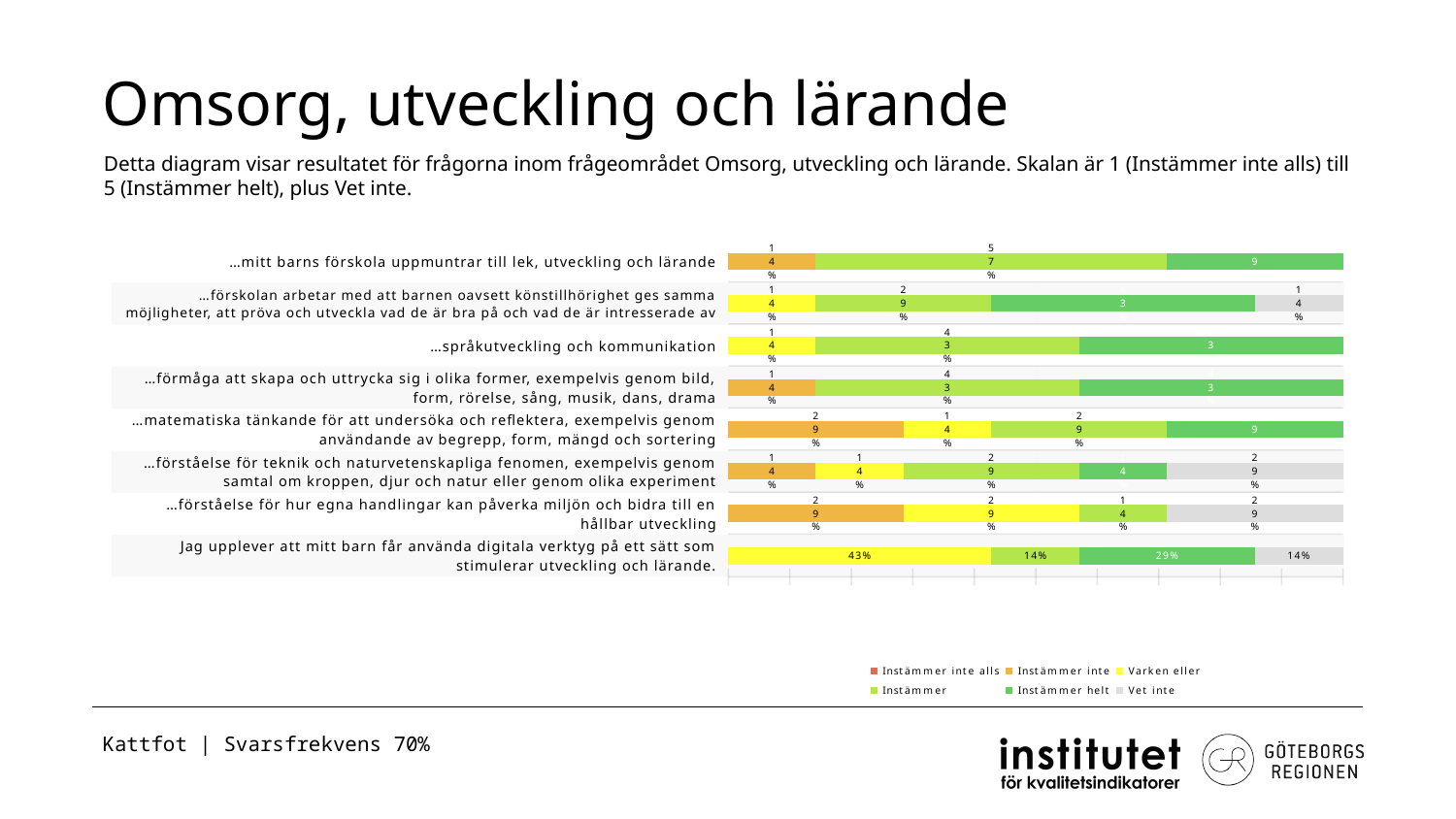
Which colour represents 'Vet inte' in the legend? Grey What is the 'Varken eller' share for 'Jag upplever att mitt barn får använda digitala verktyg på ett sätt som stimulerar utveckling och lärande.'? 43% What is the 'Vet inte' share for '…förståelse för teknik och naturvetenskapliga fenomen…'? 29% Which response category has the largest share for '…språkutveckling och kommunikation'? Instämmer and Instämmer helt (both 43%) How many question rows (categories) are plotted in the chart? 8 What type of chart is shown on the slide? Stacked bar chart What is the 'Instämmer' share for '…mitt barns förskola uppmuntrar till lek, utveckling och lärande'? 57% How many series does the legend list? 6 What is the 'Instämmer inte' share for '…matematiska tänkande för att undersöka och reflektera…'? 29%